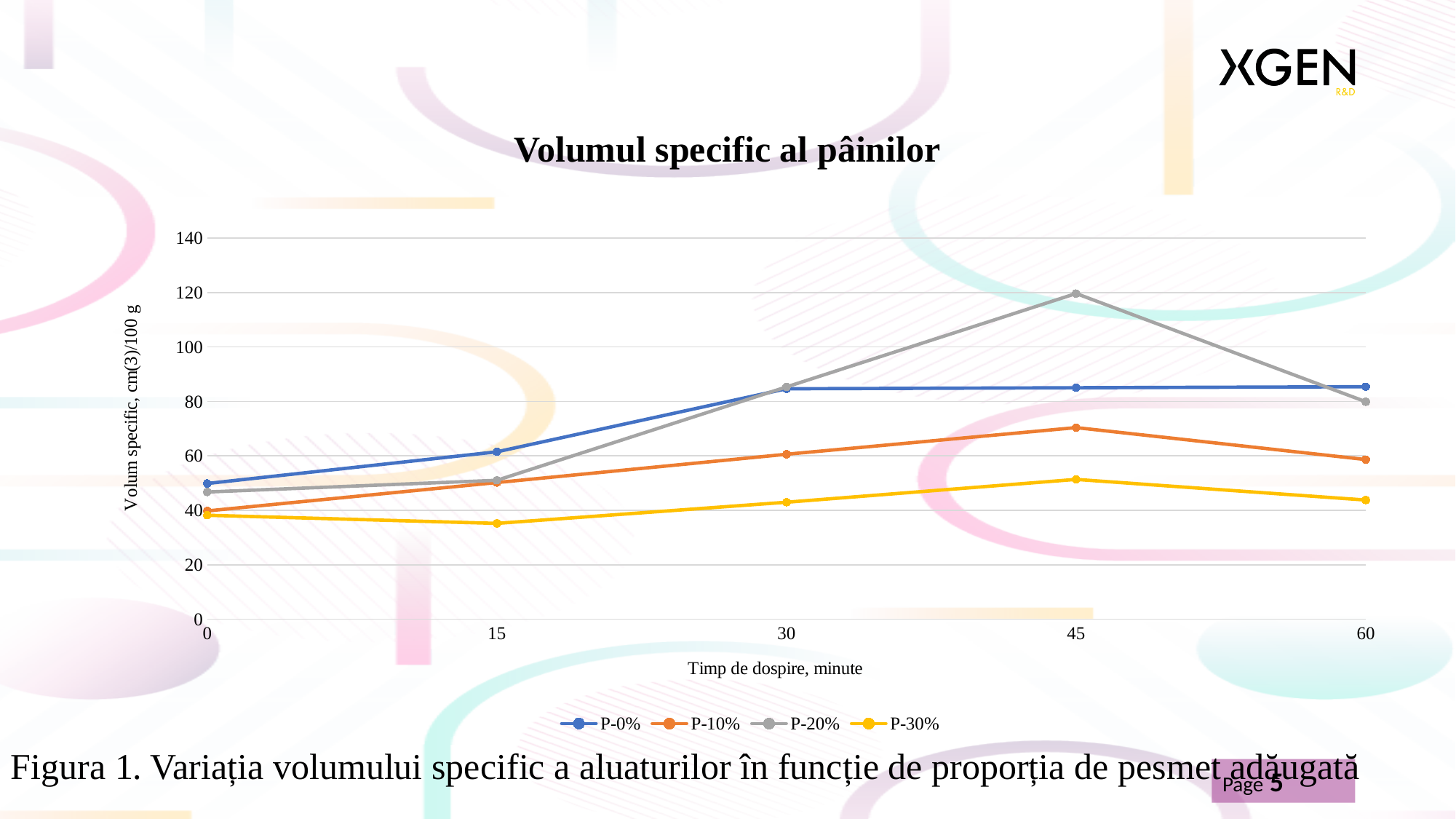
Which series reaches the highest value at 45 minutes? P-20% What is the label of the x axis? Timp de dospire, minute How many series does the legend list? 4 How many time points are plotted along the x axis? 5 Does the P-10% series rise or fall between 0 and 45 minutes? rise Is the value for P-0% at 60 minutes greater or less than 80? greater Is the value for P-20% at 45 minutes greater or less than 100? greater What is the title of the chart? Volumul specific al pâinilor At 60 minutes, which is larger: the value for P-10% or the value for P-30%? P-10% Is the value for P-30% at 15 minutes greater or less than 40? less What type of chart is shown on the slide? line chart Which series has the lowest value at 45 minutes? P-30%